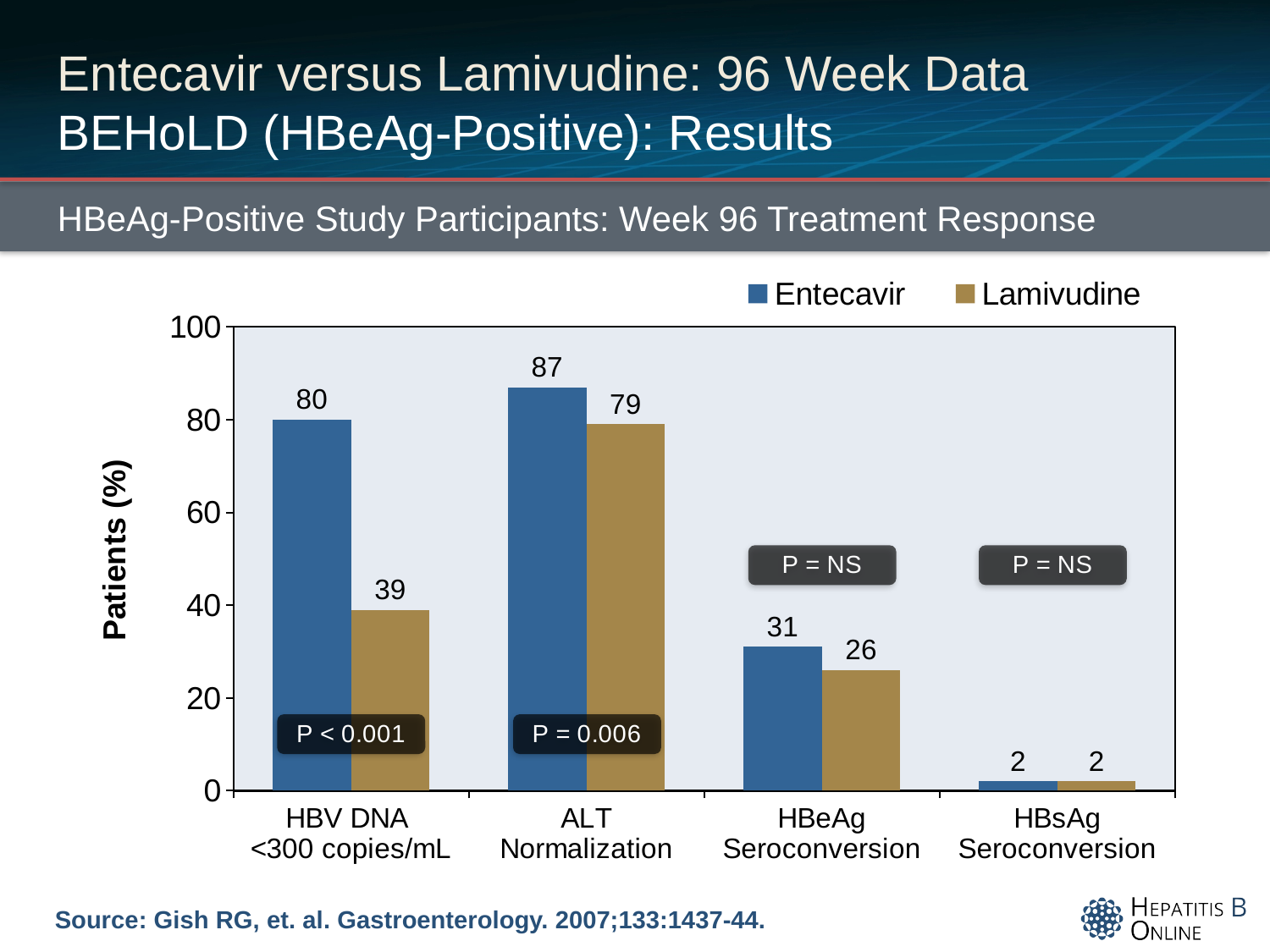
What is the value for Lamivudine in the ALT Normalization category? 79 What is the value for Entecavir in the HBV DNA <300 copies/mL category? 80 What is the value for Lamivudine in the HBeAg Seroconversion category? 26 How many categories are shown on the x axis? 4 What is the label of the y axis? Patients (%) Which category has the highest Entecavir value? ALT Normalization What kind of chart is shown on the slide? bar chart How many series does the legend list? 2 Which is larger in the HBeAg Seroconversion category, Entecavir or Lamivudine? Entecavir What is the difference between the Entecavir and Lamivudine values for HBV DNA <300 copies/mL? 41 Which category has the lowest Lamivudine value? HBsAg Seroconversion Is the Lamivudine value for HBV DNA <300 copies/mL greater or less than 40? less